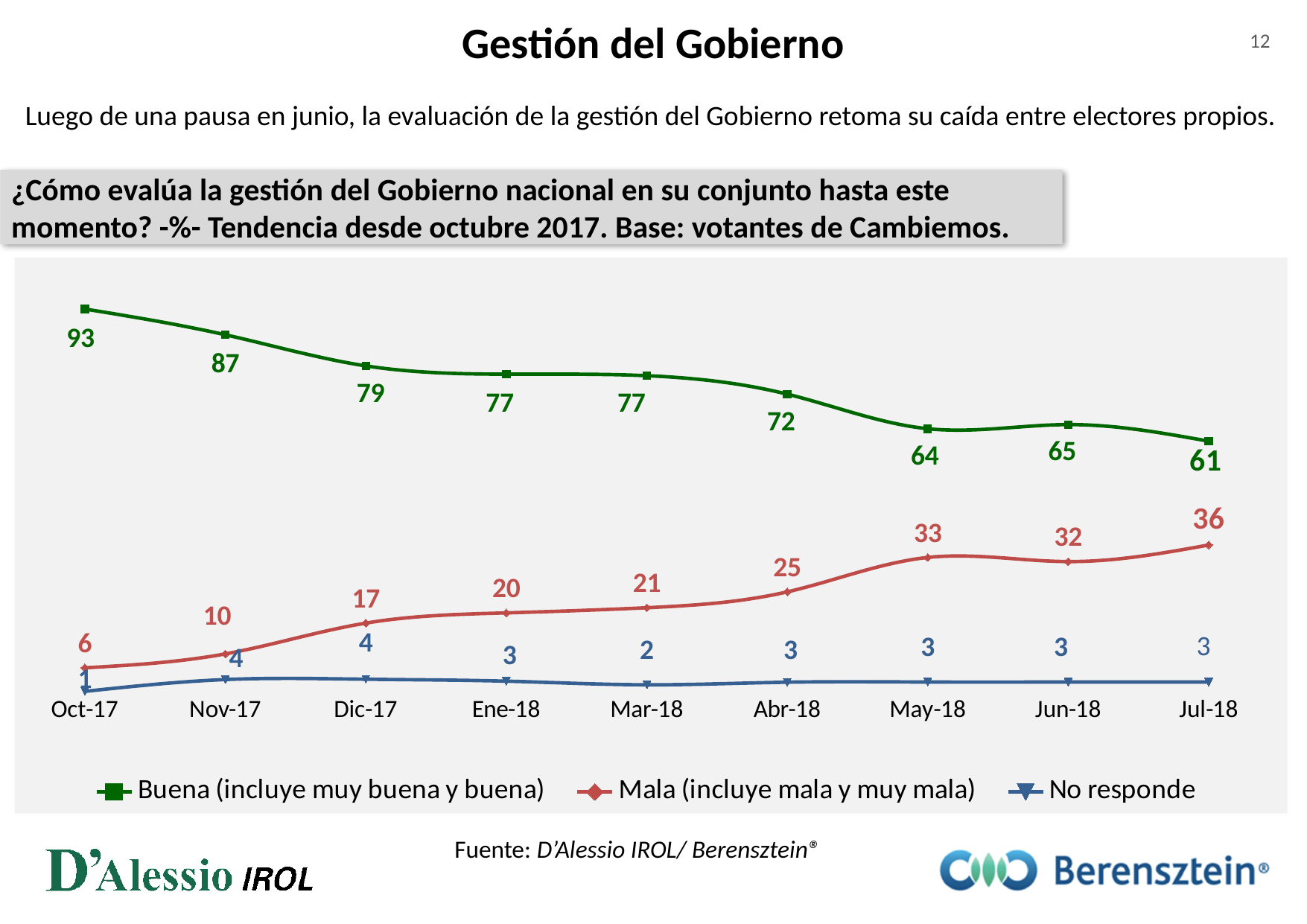
What kind of chart is shown on the slide? line chart How many series does the legend list? 3 What is the difference between the 'Buena' value in Oct-17 and in Jul-18? 32 How many time points are shown on the x axis? 9 In which month is the 'Buena' series at its lowest? Jul-18 What is the value for 'No responde' in Mar-18? 2 What colour is the line for 'Buena (incluye muy buena y buena)'? green Which is larger in May-18: the 'Mala' value or the 'No responde' value? Mala What is the value for 'Mala (incluye mala y muy mala)' in Jul-18? 36 Does the 'Mala (incluye mala y muy mala)' series generally rise or fall from Oct-17 to Jul-18? rise In which month is the 'Mala' series at its highest? Jul-18 What is the value for 'Buena (incluye muy buena y buena)' in Oct-17? 93